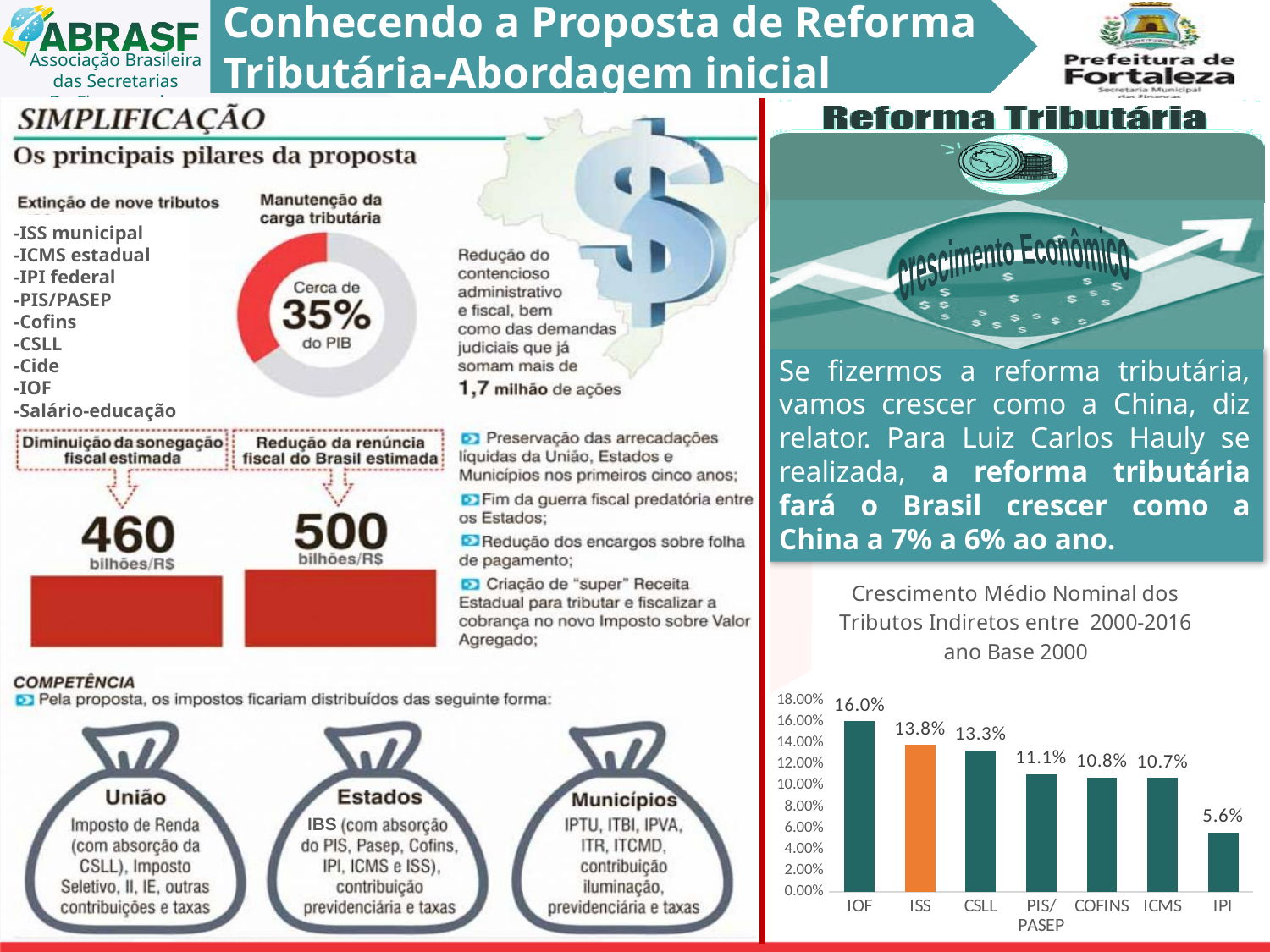
In the bar chart titled 'Crescimento Médio Nominal dos Tributos Indiretos entre 2000-2016 ano Base 2000', which category has the highest value? IOF In the bar chart titled 'Crescimento Médio Nominal dos Tributos Indiretos entre 2000-2016 ano Base 2000', what is the value for PIS/PASEP? 11.1% In the bar chart titled 'Crescimento Médio Nominal dos Tributos Indiretos entre 2000-2016 ano Base 2000', what is the value for IOF? 16.0% In the bar chart titled 'Crescimento Médio Nominal dos Tributos Indiretos entre 2000-2016 ano Base 2000', what is the value for ISS? 13.8% What kind of chart is the chart titled 'Crescimento Médio Nominal dos Tributos Indiretos entre 2000-2016 ano Base 2000'? Bar chart In the bar chart titled 'Crescimento Médio Nominal dos Tributos Indiretos entre 2000-2016 ano Base 2000', what is the difference between the values for IOF and ISS? 2.2% In the bar chart titled 'Crescimento Médio Nominal dos Tributos Indiretos entre 2000-2016 ano Base 2000', what is the value for IPI? 5.6% In the bar chart titled 'Crescimento Médio Nominal dos Tributos Indiretos entre 2000-2016 ano Base 2000', which category's bar is coloured orange instead of teal? ISS In the bar chart titled 'Crescimento Médio Nominal dos Tributos Indiretos entre 2000-2016 ano Base 2000', which is larger, the value for CSLL or the value for COFINS? CSLL In the bar chart titled 'Crescimento Médio Nominal dos Tributos Indiretos entre 2000-2016 ano Base 2000', which category has the lowest value? IPI In the bar chart titled 'Crescimento Médio Nominal dos Tributos Indiretos entre 2000-2016 ano Base 2000', do the values rise or fall from left to right along the x axis? Fall In the bar chart titled 'Crescimento Médio Nominal dos Tributos Indiretos entre 2000-2016 ano Base 2000', how many categories are shown? 7